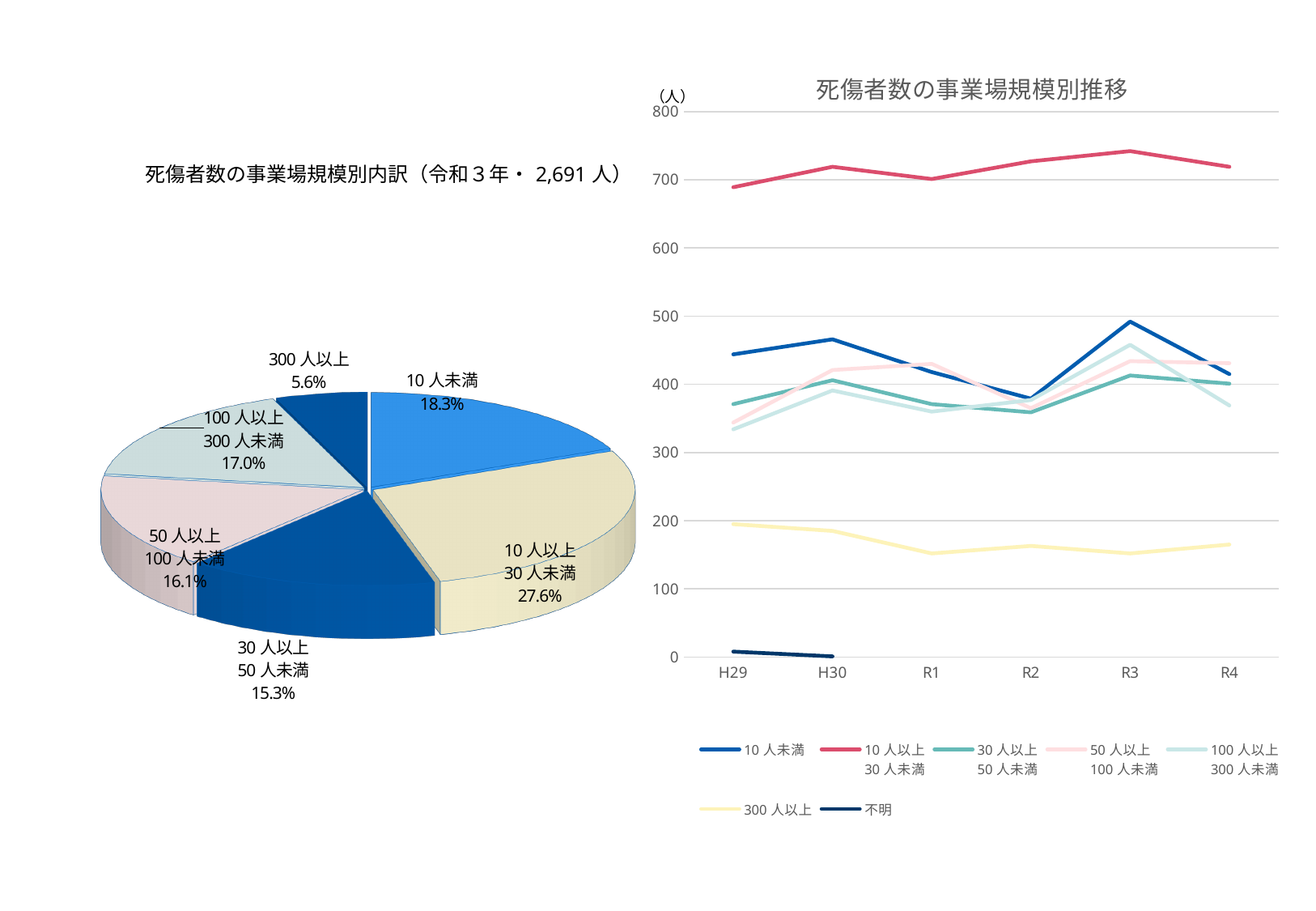
How many series does the legend of the line chart on the right list? 7 What kind of chart is the chart on the right titled 死傷者数の事業場規模別推移? line chart In the pie chart on the left, what is the difference in percentage points between 10人未満 and 30人以上50人未満? 3.0 In the pie chart on the left, what percentage is shown for 300人以上? 5.6% In the pie chart on the left, which is larger: 50人以上100人未満 or 100人以上300人未満? 100人以上300人未満 In the line chart on the right, is the value for 10人以上30人未満 at R3 greater or less than 700? greater In the pie chart on the left, which category has the smallest share? 300人以上 How many slices does the pie chart on the left have? 6 In the pie chart on the left, which category has the largest share? 10人以上30人未満 In the line chart on the right, is the value for 300人以上 at R1 greater or less than 200? less In the line chart on the right, does the 300人以上 series rise or fall from H29 to R1? fall In the pie chart on the left, what share of the total is the 10人以上30人未満 category? 27.6%